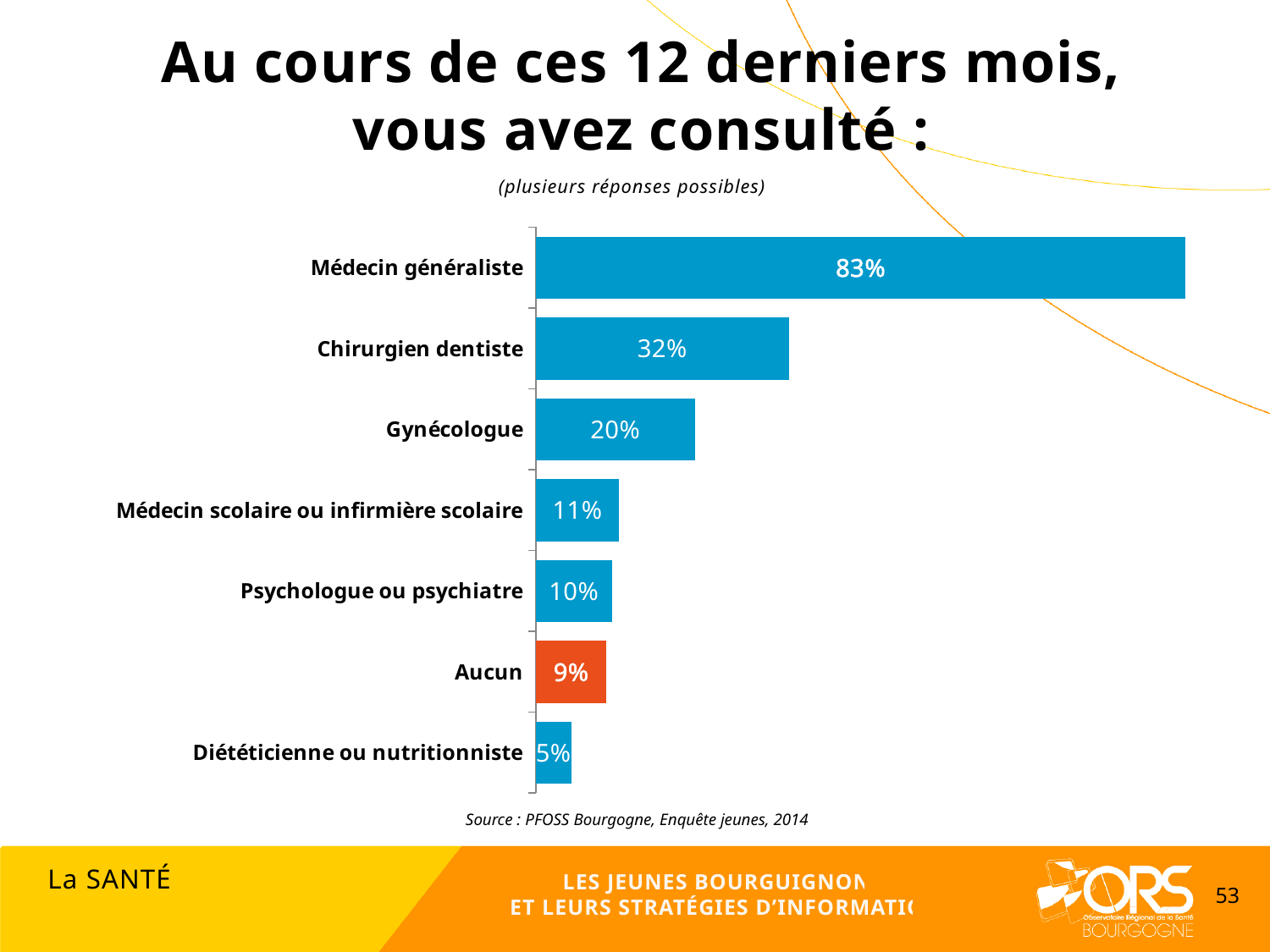
What percentage is shown for Aucun? 9% Which category has the highest value? Médecin généraliste What is the value shown for Gynécologue? 20% What is the value shown for Chirurgien dentiste? 32% What kind of chart is shown on the slide? Bar chart Which category's bar is coloured orange instead of blue? Aucun What percentage of respondents consulted a Médecin généraliste? 83% Which is larger, the value for Médecin scolaire ou infirmière scolaire or the value for Diététicienne ou nutritionniste? Médecin scolaire ou infirmière scolaire Which category has the lowest value? Diététicienne ou nutritionniste What is the difference between the values for Médecin généraliste and Chirurgien dentiste? 51% How many categories are shown in the chart? 7 What is the difference between the values for Gynécologue and Psychologue ou psychiatre? 10%